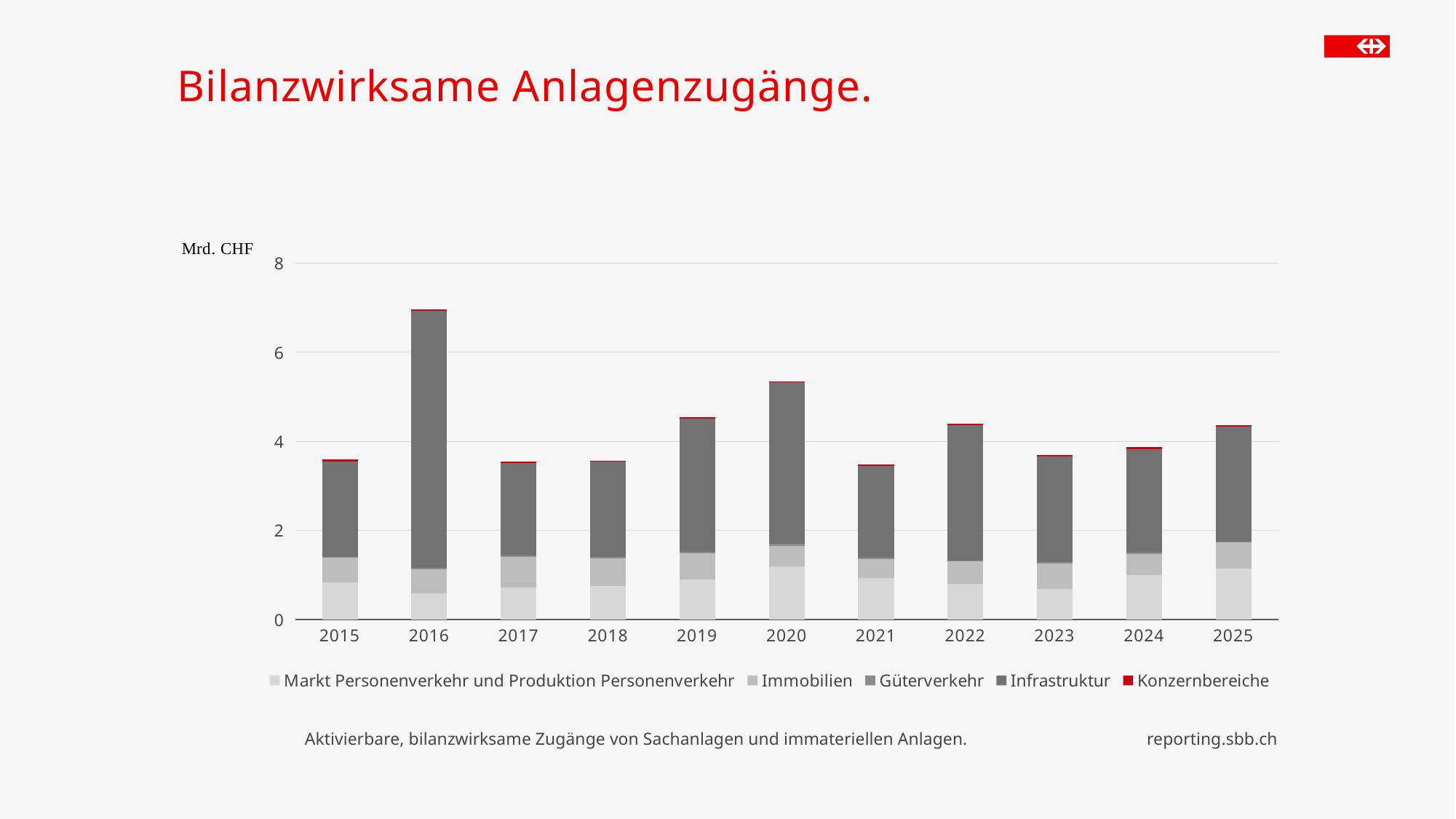
Is the total value for 2018 greater or less than 4 Mrd. CHF? less Is the total value for 2016 greater or less than 6 Mrd. CHF? greater Which year has the larger total bar, 2019 or 2020? 2020 Which year has the highest total bar in the chart? 2016 What is the title of the slide's chart? Bilanzwirksame Anlagenzugänge. What kind of chart is shown on the slide? Stacked bar chart How many years are shown on the x axis of the chart? 11 Which year has the larger total bar, 2016 or 2020? 2016 What unit is shown on the y axis of the chart? Mrd. CHF How many series does the chart's legend list? 5 Is the total value for 2021 greater or less than 4 Mrd. CHF? less